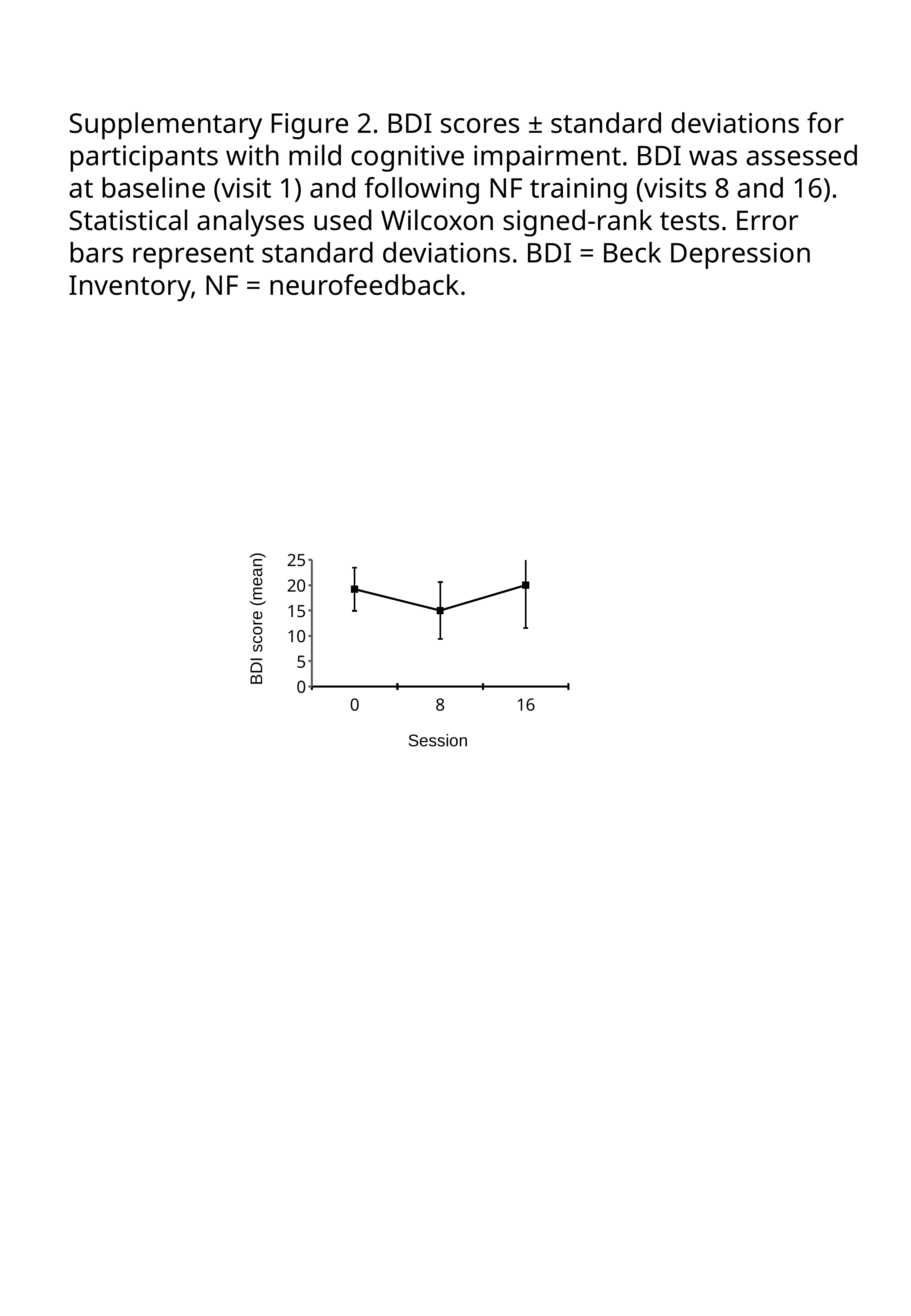
What is the label of the x axis? Session Which has the larger mean BDI score, session 0 or session 8? session 0 Does the mean BDI score rise or fall from session 0 to session 8? fall At which session is the mean BDI score lowest? 8 Does the mean BDI score rise or fall from session 8 to session 16? rise Is the mean BDI score at session 8 greater or less than 20? less Is the mean BDI score at session 16 greater or less than 15? greater What is the label of the y axis? BDI score (mean) What kind of chart is shown on the slide? line chart How many data points are plotted on the chart? 3 Is the mean BDI score at session 0 greater or less than 15? greater